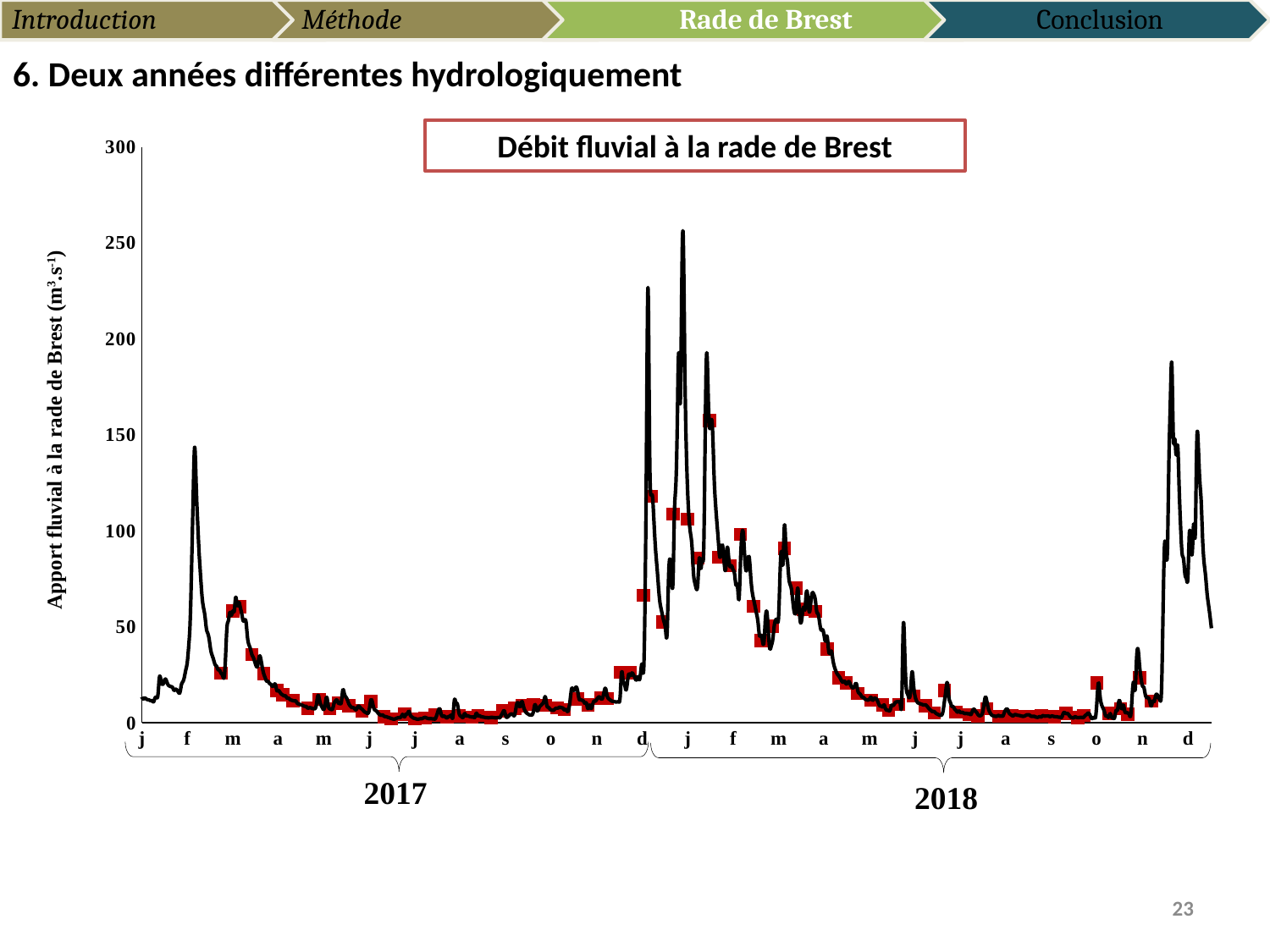
Is the peak in December 2018 greater or less than 150? greater What is the title of the chart? Débit fluvial à la rade de Brest Do the values rise or fall from January 2018 to September 2018? fall What is the label of the y axis? Apport fluvial à la rade de Brest (m³.s⁻¹) What kind of chart is shown on the slide? line chart Is the peak in February 2017 greater or less than 100? greater How many years does the x axis cover? 2 What is the maximum value shown on the y axis? 300 Is the highest peak in January 2018 greater or less than 200? greater Which year contains the highest peak in river discharge, 2017 or 2018? 2018 Is the peak in February 2017 larger or smaller than the peak in January 2018? smaller